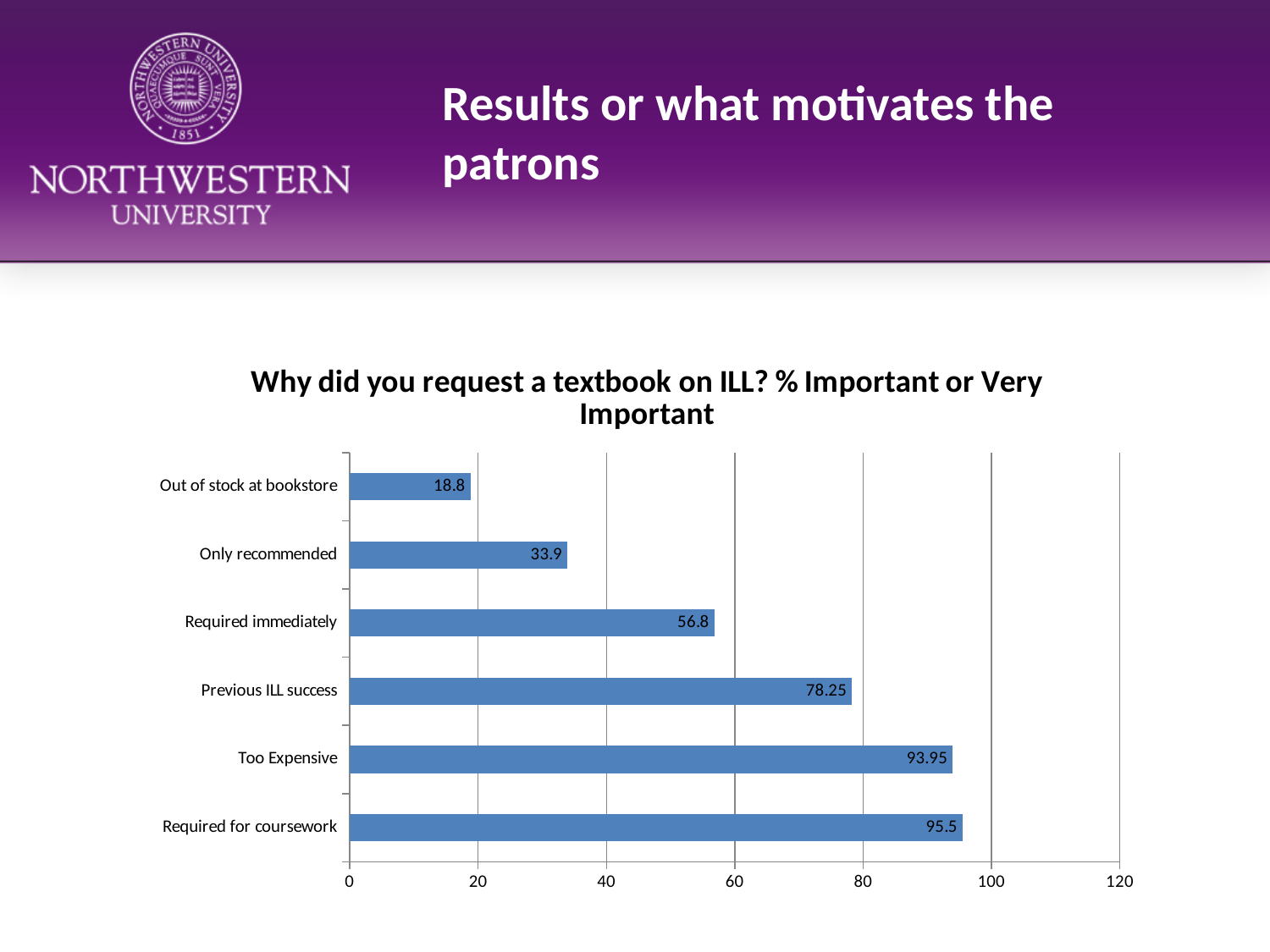
What is the value for Only recommended? 33.9 Which is larger, the value for Previous ILL success or the value for Required immediately? Previous ILL success What is the value for Previous ILL success? 78.25 What kind of chart is shown on the slide? bar chart What is the difference between the values for Required immediately and Out of stock at bookstore? 38 What is the value for Required for coursework? 95.5 Which category has the lowest value? Out of stock at bookstore What is the title of the chart? Why did you request a textbook on ILL? % Important or Very Important Which category has the highest value? Required for coursework How many categories are shown in the chart? 6 Is the value for Only recommended greater or less than 40? less What is the value for Too Expensive? 93.95